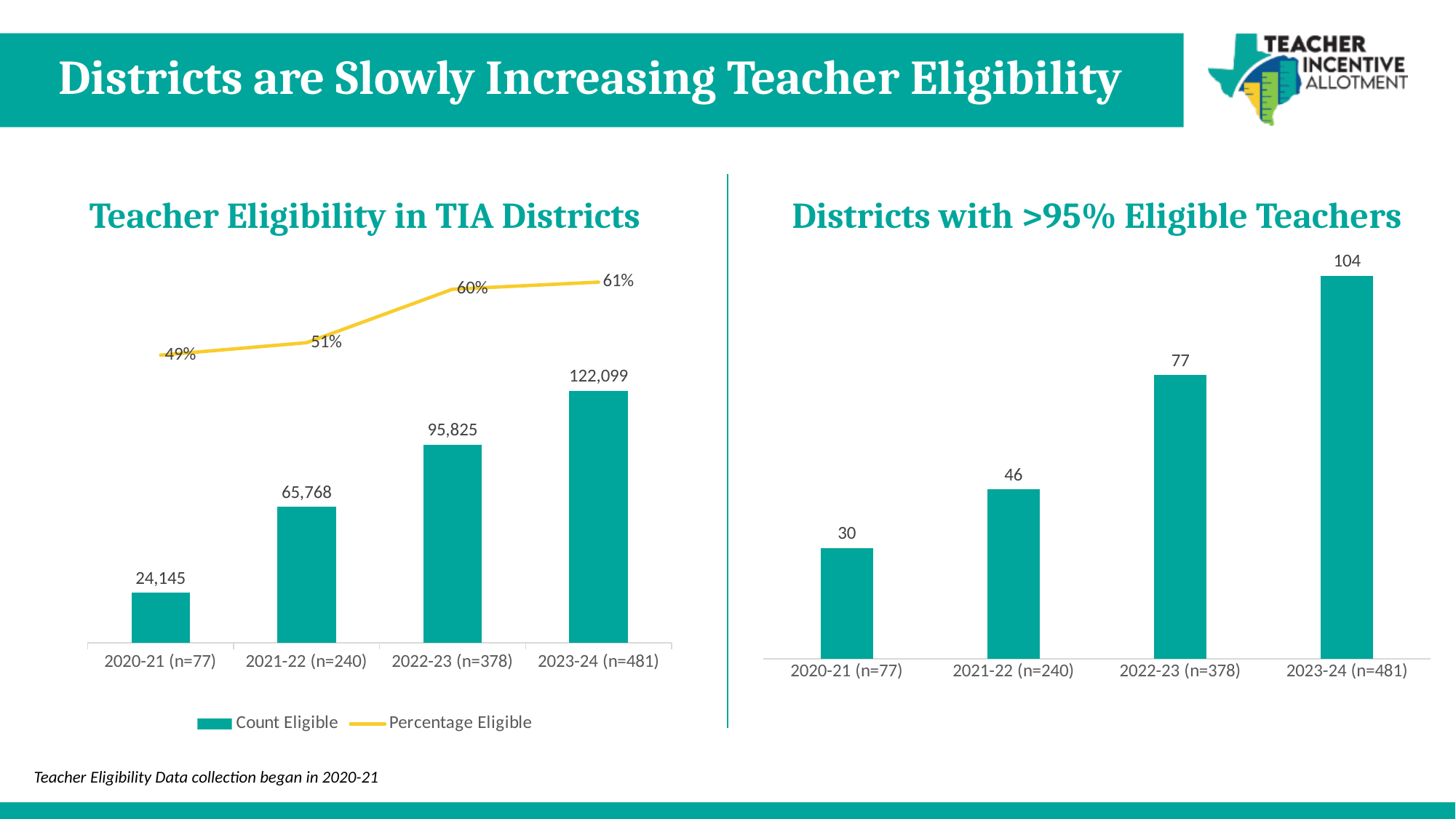
In the 'Districts with >95% Eligible Teachers' chart, what is the difference between 2023-24 (n=481) and 2020-21 (n=77)? 74 In the 'Districts with >95% Eligible Teachers' chart, what is the value for 2021-22 (n=240)? 46 In the 'Teacher Eligibility in TIA Districts' chart, how many series does the legend list? 2 In the 'Teacher Eligibility in TIA Districts' chart, does the Percentage Eligible rise or fall from 2020-21 to 2023-24? rise In the 'Teacher Eligibility in TIA Districts' chart, what colour is the Percentage Eligible line? yellow What kind of chart is 'Districts with >95% Eligible Teachers'? bar chart In the 'Districts with >95% Eligible Teachers' chart, how many categories are shown on the x axis? 4 In the 'Teacher Eligibility in TIA Districts' chart, what is the difference in Count Eligible between 2023-24 (n=481) and 2022-23 (n=378)? 26,274 In the 'Teacher Eligibility in TIA Districts' chart, what is the Count Eligible for 2022-23 (n=378)? 95,825 In the 'Districts with >95% Eligible Teachers' chart, which year has the lowest value? 2020-21 (n=77) In the 'Teacher Eligibility in TIA Districts' chart, what is the Percentage Eligible for 2020-21 (n=77)? 49% In the 'Teacher Eligibility in TIA Districts' chart, which year has the highest Count Eligible? 2023-24 (n=481)